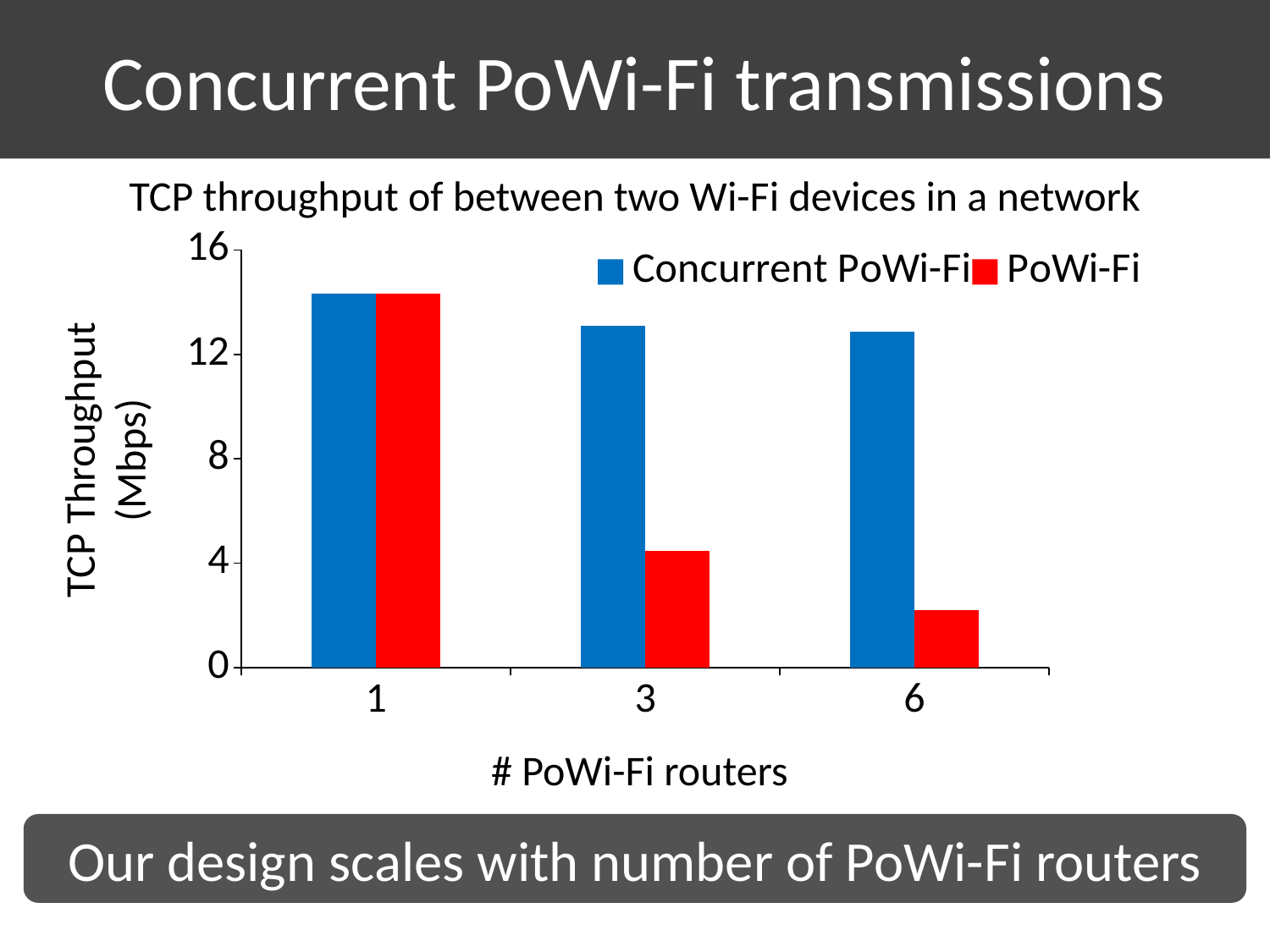
Is the PoWi-Fi value for 6 routers greater or less than 4? less Which colour represents the PoWi-Fi series? red What is the title of the chart? TCP throughput of between two Wi-Fi devices in a network What kind of chart is shown on the slide? bar chart For the Concurrent PoWi-Fi series, at which number of routers is the TCP throughput highest? 1 Is the PoWi-Fi value for 3 routers greater or less than 8? less Is the Concurrent PoWi-Fi value for 6 routers greater or less than 12? greater How many series does the legend list? 2 How many categories of # PoWi-Fi routers are shown on the x axis? 3 For the PoWi-Fi series, at which number of routers is the TCP throughput lowest? 6 Does the PoWi-Fi throughput rise or fall as the number of PoWi-Fi routers increases? fall At 3 PoWi-Fi routers, which series has the larger TCP throughput, Concurrent PoWi-Fi or PoWi-Fi? Concurrent PoWi-Fi